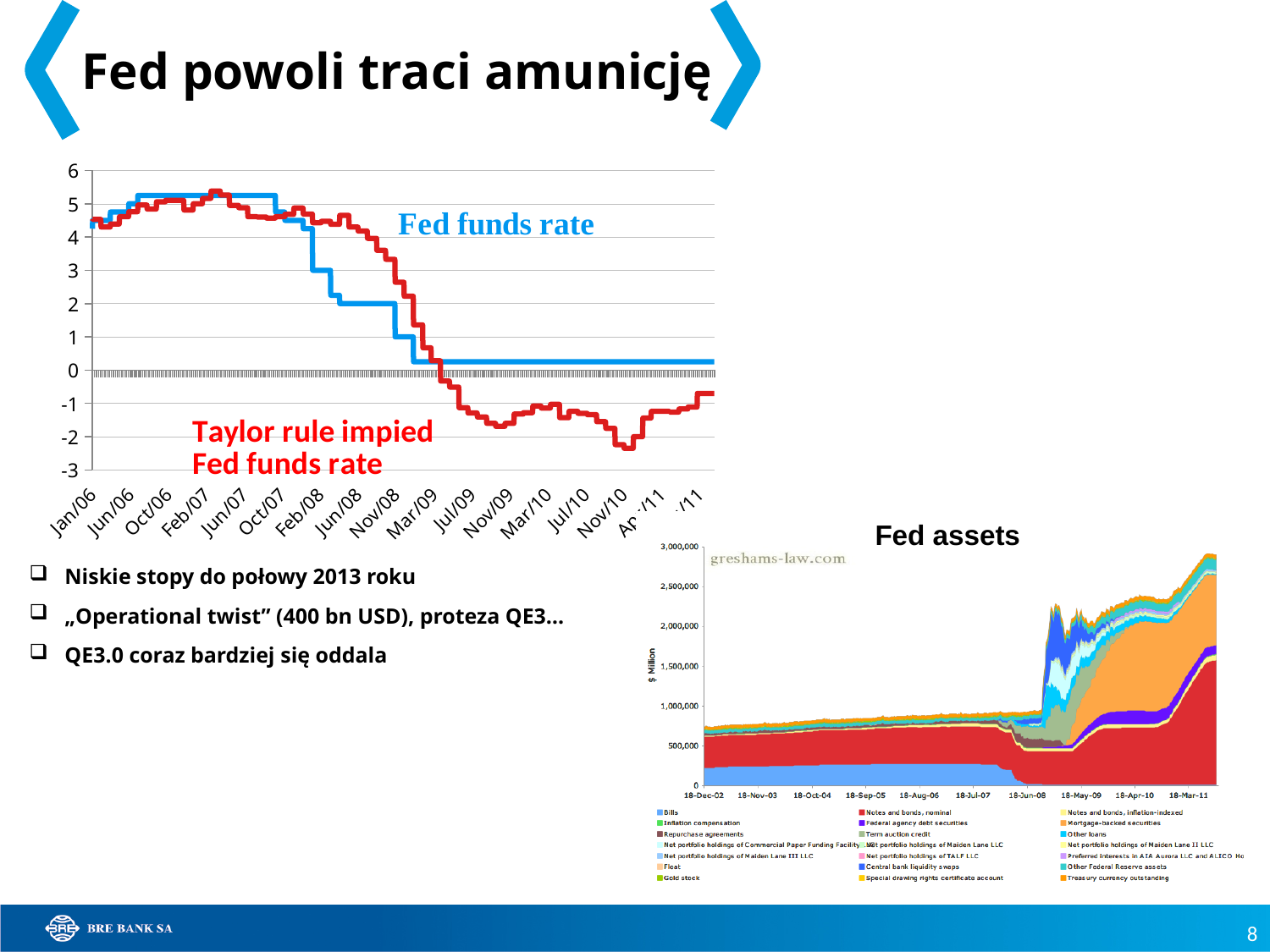
On the top-left chart, is the Fed funds rate in Jun/07 greater or less than 5? greater On the top-left chart, is the Fed funds rate in Jul/09 greater or less than 1? less On the 'Fed assets' chart, is the total of Fed assets at 18-Mar-11 greater or less than 2,500,000? greater What is the highest value shown on the y axis of the top-left chart? 6 What kind of chart is the 'Fed assets' chart? Stacked area chart On the top-left chart, which series is higher in Nov/10: the Fed funds rate or the Taylor rule implied Fed funds rate? Fed funds rate On the top-left chart, does the Fed funds rate rise or fall between Feb/08 and Mar/09? Fall How many series are plotted on the top-left Fed funds rate chart? 2 On the top-left chart, what are the two series labelled? Fed funds rate and Taylor rule implied Fed funds rate What kind of chart is the top-left chart showing the Fed funds rate? Line chart